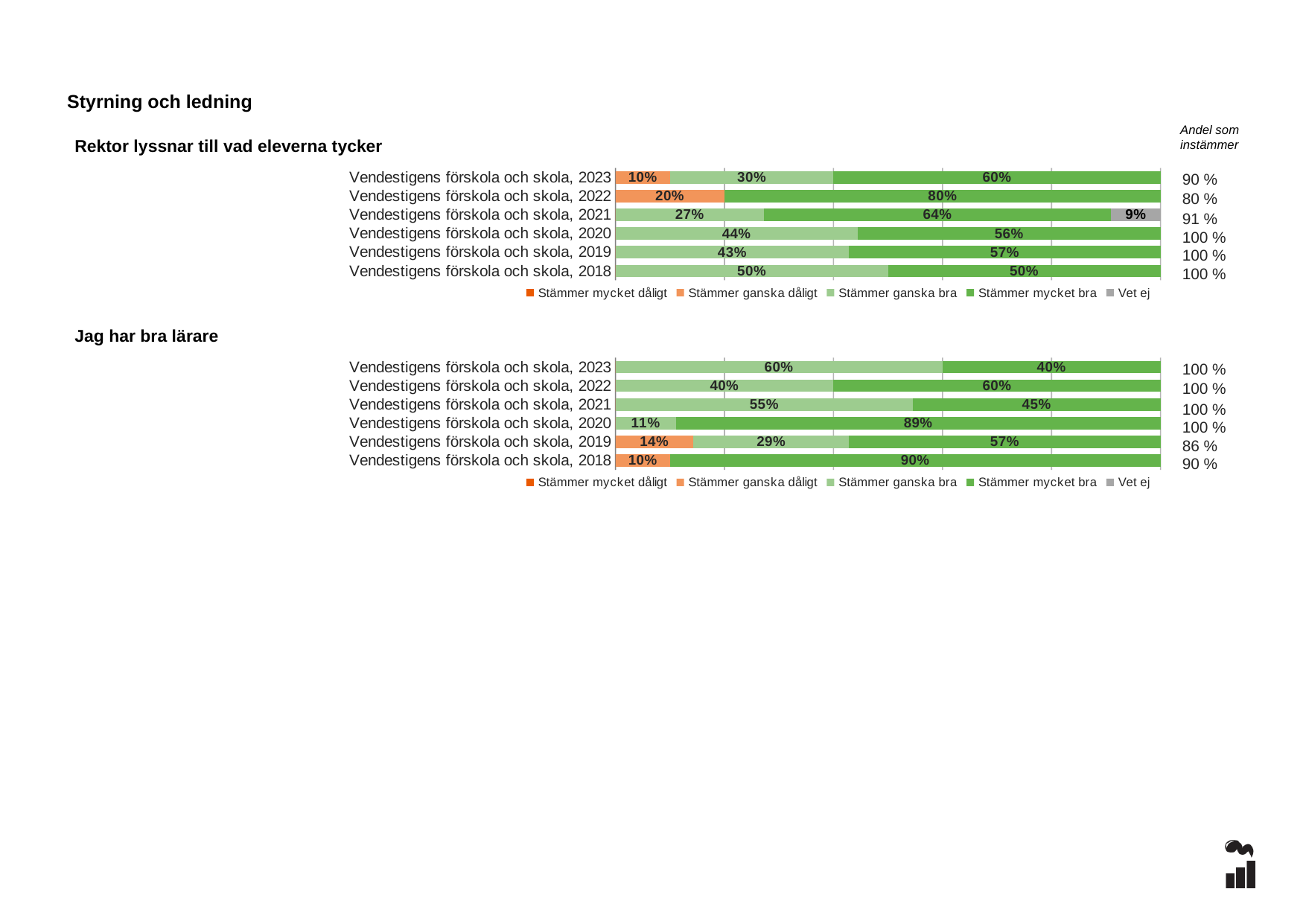
In the chart 'Rektor lyssnar till vad eleverna tycker', what is the 'Vet ej' value for Vendestigens förskola och skola, 2021? 9% How many bars (years) are shown in the chart 'Jag har bra lärare'? 6 In the chart 'Jag har bra lärare', what is the value for 'Stämmer mycket bra' for Vendestigens förskola och skola, 2020? 89% In the chart 'Jag har bra lärare', which year has the highest 'Stämmer mycket bra' value? 2018 In the chart 'Rektor lyssnar till vad eleverna tycker', which year has the lowest 'Andel som instämmer'? 2022 In the chart 'Rektor lyssnar till vad eleverna tycker', what is the value for 'Stämmer mycket bra' for Vendestigens förskola och skola, 2022? 80% In the chart 'Rektor lyssnar till vad eleverna tycker', what is the 'Andel som instämmer' value for Vendestigens förskola och skola, 2023? 90 % In the chart 'Jag har bra lärare', is the 'Stämmer ganska bra' value larger for 2023 or for 2022? 2023 In the chart 'Jag har bra lärare', what is the 'Stämmer ganska dåligt' value for Vendestigens förskola och skola, 2019? 14% In the chart 'Rektor lyssnar till vad eleverna tycker', what is the difference between the 'Stämmer mycket bra' values for 2022 and 2023? 20% How many series does the legend of the chart 'Rektor lyssnar till vad eleverna tycker' list? 5 In the chart 'Jag har bra lärare', what is the 'Andel som instämmer' value for Vendestigens förskola och skola, 2019? 86 %